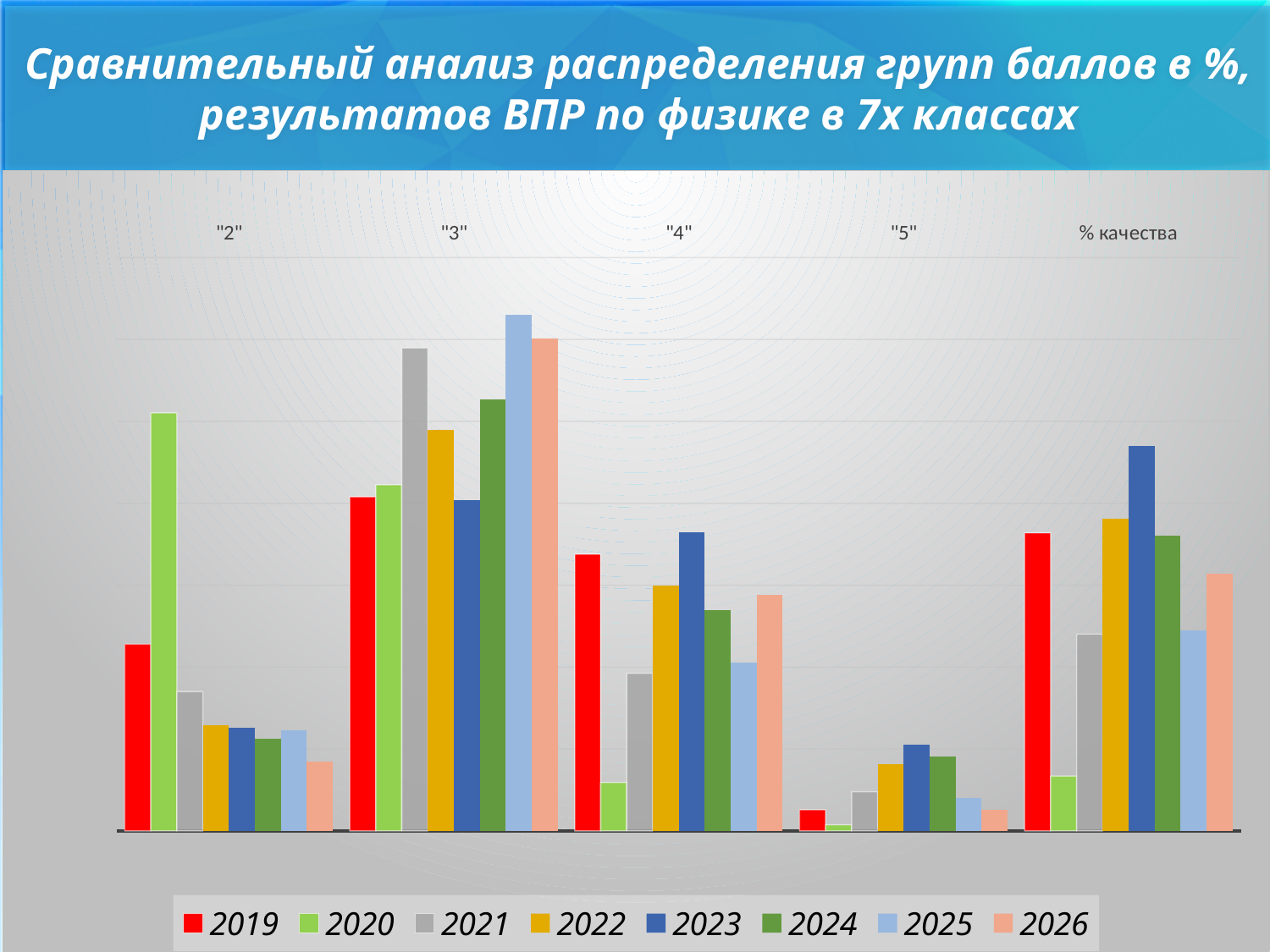
Which year has the lowest bar in the "5" category? 2020 Which year has the lowest bar in the "4" category? 2020 In the "% качества" category, which is larger: the bar for 2019 or the bar for 2021? 2019 Which year has the highest bar in the "3" category? 2025 How many categories are shown along the x axis? 5 In the "4" category, which is larger: the bar for 2022 or the bar for 2025? 2022 Which year has the lowest bar in the "2" category? 2026 Which year has the highest bar in the "% качества" category? 2023 What kind of chart is shown on the slide? bar chart How many series does the legend list? 8 Which colour represents the year 2019 in the legend? red Which year has the highest bar in the "2" category? 2020